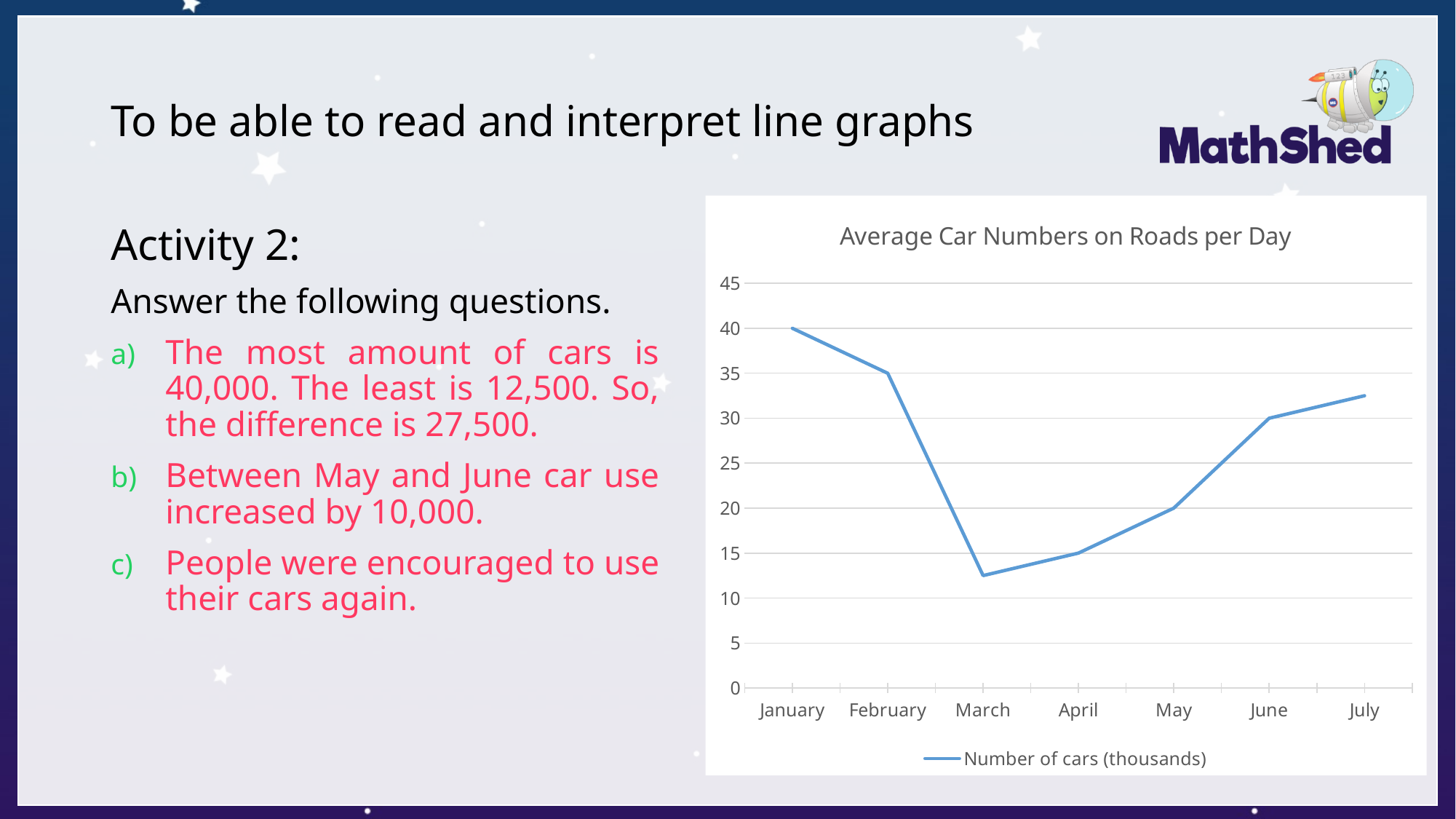
How many months are plotted on the x axis of the chart? 7 What is the title of the chart? Average Car Numbers on Roads per Day Which month has the lowest value on the chart? March Is the value for March greater or less than 15? less What is the value for January on the chart? 40 What kind of chart is shown on the slide? line chart Which month has the highest value on the chart? January What is the value for May on the chart? 20 By how much does the value increase from May to June? 10 What is the value for June on the chart? 30 How many series does the chart's legend list? 1 What is the value for February on the chart? 35